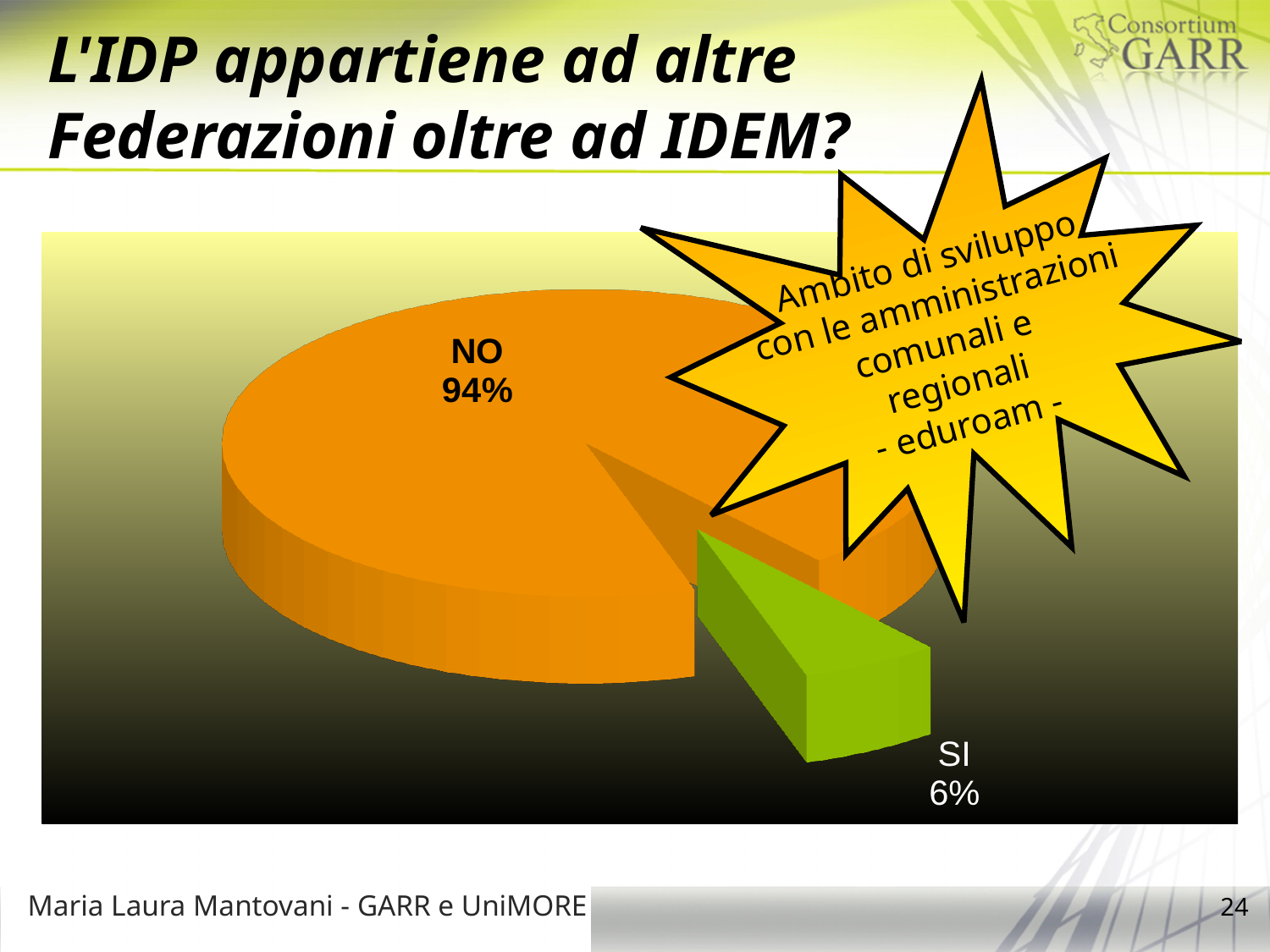
What kind of chart is shown on the slide? pie chart Which slice of the pie is the largest? NO How many slices does the pie chart have? 2 What colour is the NO slice of the pie? orange What percentage of the pie is labelled NO? 94% Which is larger, the NO slice or the SI slice? NO What is the difference in percentage points between the NO slice and the SI slice? 88 Is the share for NO greater or less than 50%? greater What colour is the SI slice of the pie? green What percentage of the pie is labelled SI? 6% What share of the pie does the SI slice represent? 6% Which slice of the pie is the smallest? SI